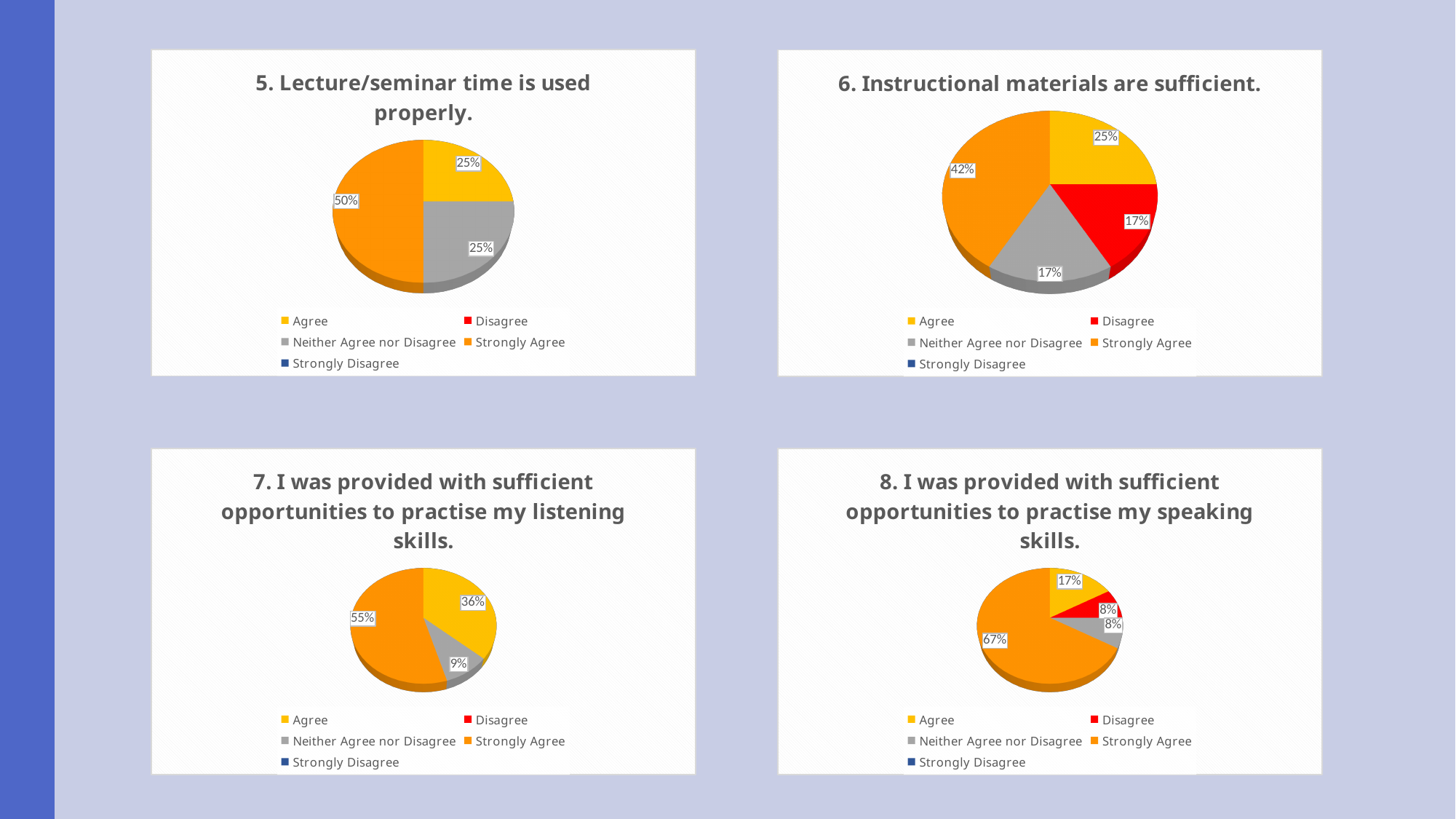
In the chart titled "6. Instructional materials are sufficient.", which response has the largest slice? Strongly Agree In the chart titled "7. I was provided with sufficient opportunities to practise my listening skills.", what is the difference between the Strongly Agree and Agree percentages? 19% What kind of chart is used for "6. Instructional materials are sufficient."? Pie chart In the chart titled "6. Instructional materials are sufficient.", what percentage is shown for Disagree? 17% In the chart titled "5. Lecture/seminar time is used properly.", what share of the pie is Strongly Agree? 50% In the chart titled "8. I was provided with sufficient opportunities to practise my speaking skills.", how many slices are labelled with a percentage? 4 In the chart titled "6. Instructional materials are sufficient.", what percentage is shown for Strongly Agree? 42% How many entries does the legend list in the chart titled "7. I was provided with sufficient opportunities to practise my listening skills."? 5 In the chart titled "8. I was provided with sufficient opportunities to practise my speaking skills.", what percentage is shown for Strongly Agree? 67% In the chart titled "5. Lecture/seminar time is used properly.", what percentage is shown for Agree? 25% In the chart titled "8. I was provided with sufficient opportunities to practise my speaking skills.", which is larger, Agree or Disagree? Agree In the chart titled "7. I was provided with sufficient opportunities to practise my listening skills.", what percentage is shown for Neither Agree nor Disagree? 9%